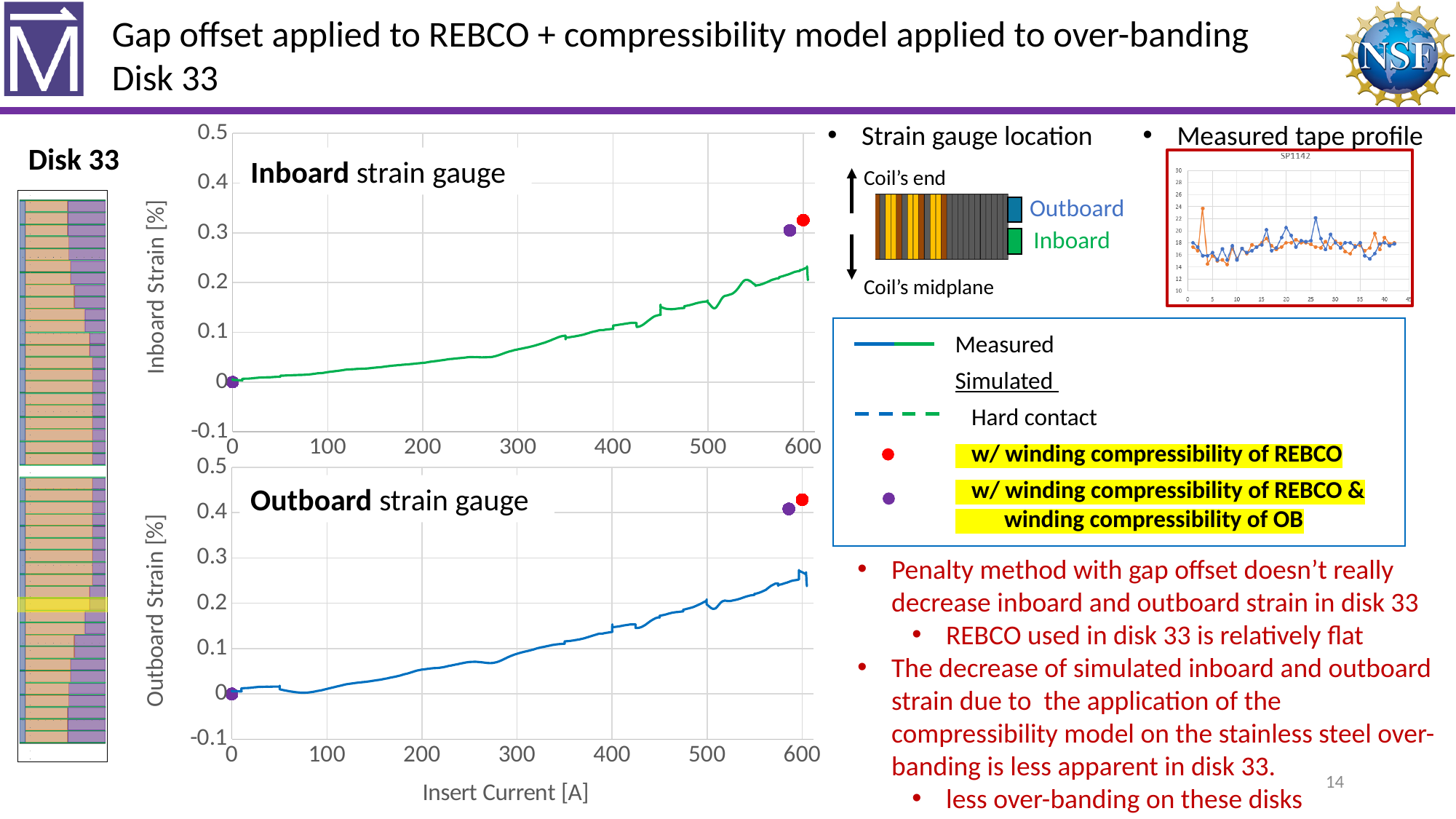
In the Outboard strain gauge chart, is the red simulated point (w/ winding compressibility of REBCO) greater or less than 0.4? greater In the Outboard strain gauge chart, is the measured strain at 600 A greater or less than 0.3? less How many labelled tick values are on the x axis of the Outboard strain gauge chart? 7 What is the highest tick value on the y axis of the Inboard strain gauge chart? 0.5 Which chart shows a higher red simulated point (w/ winding compressibility of REBCO): the Inboard strain gauge chart or the Outboard strain gauge chart? Outboard strain gauge chart In the Outboard strain gauge chart, does the measured strain rise or fall as insert current increases? rise In the Inboard strain gauge chart, is the measured strain at 600 A greater or less than 0.3? less What is the x-axis label shared by the Inboard and Outboard strain gauge charts? Insert Current [A] In the Outboard strain gauge chart, which is larger at about 600 A: the red simulated point or the measured strain? the red simulated point In the Inboard strain gauge chart, does the measured strain rise or fall as insert current increases? rise What kind of chart is the Inboard strain gauge chart? line chart